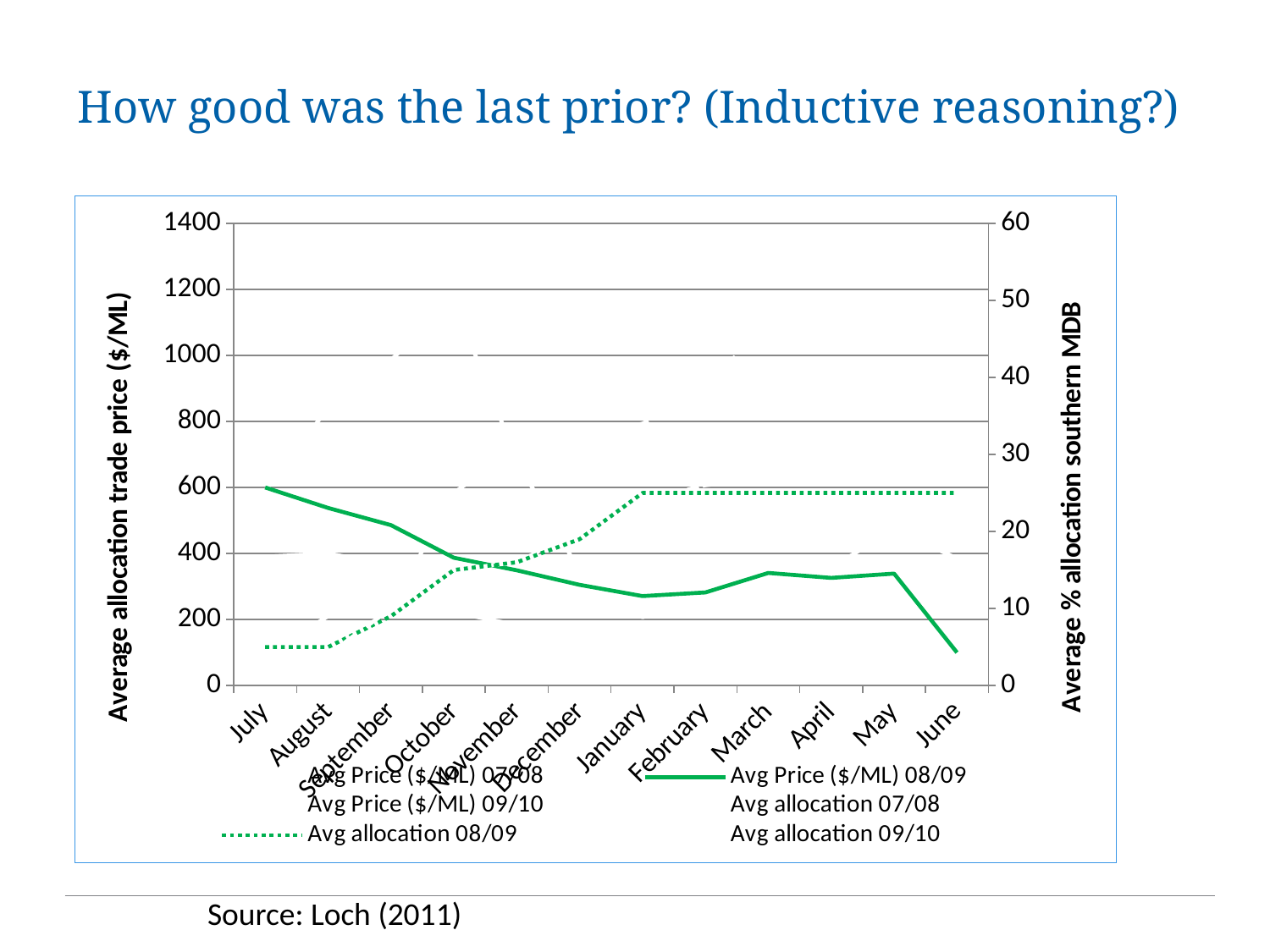
Is the Avg Price ($/ML) 08/09 value for June greater or less than 200? less Is the Avg allocation 08/09 value for July greater or less than 10? less Does the Avg Price ($/ML) 08/09 line generally rise or fall from July to June? fall Does the Avg allocation 08/09 line generally rise or fall from July to January? rise Which month has the larger Avg Price ($/ML) 08/09 value, July or June? July Is the Avg allocation 08/09 value for March greater or less than 20? greater What is the title of the left vertical axis? Average allocation trade price ($/ML) What kind of chart is shown on the slide? line chart In which month is the Avg Price ($/ML) 08/09 line at its lowest? June How many months are shown along the x axis? 12 In which month is the Avg Price ($/ML) 08/09 line at its highest? July How many series does the legend list? 6